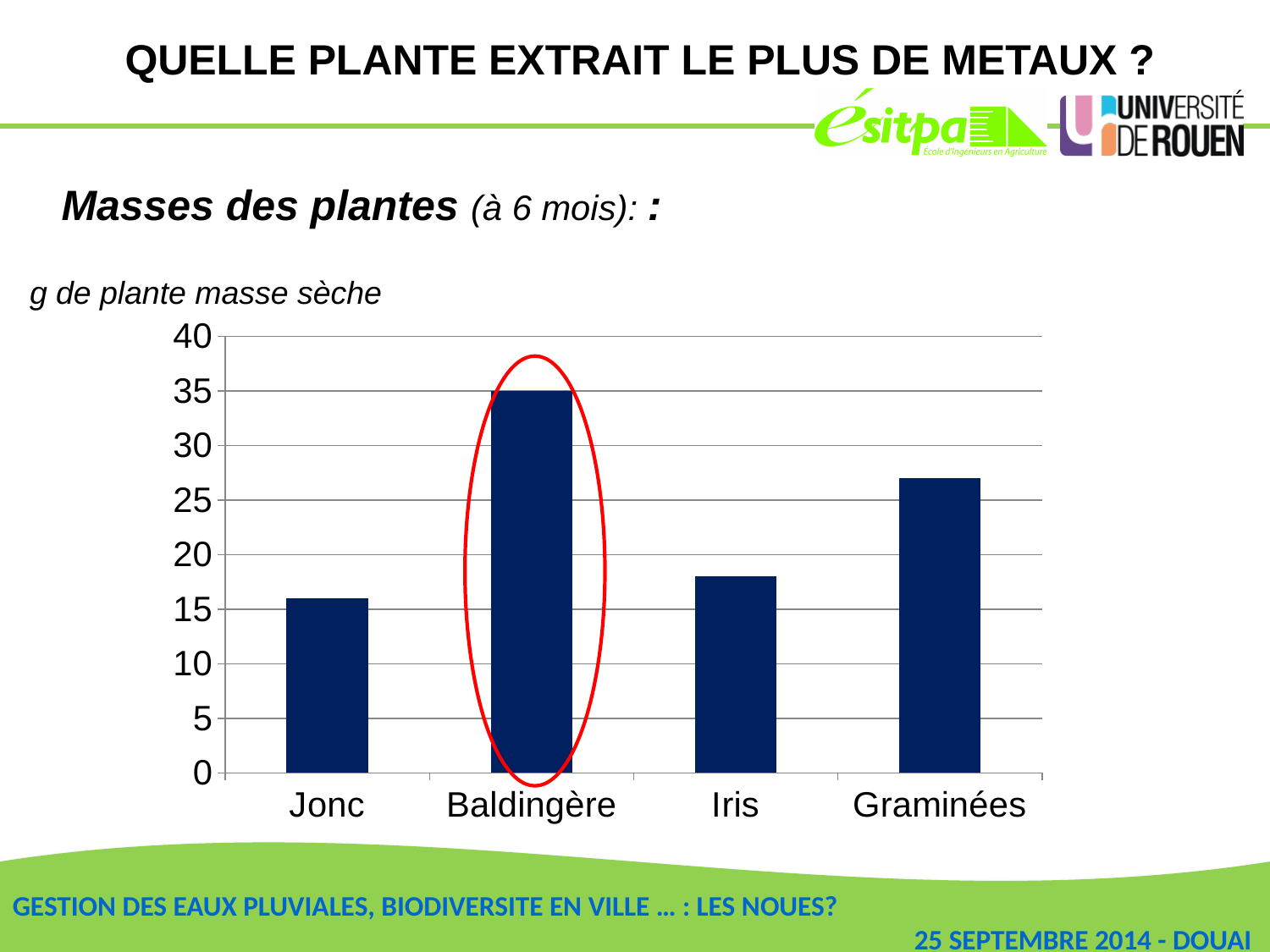
What type of chart is shown on the slide? bar chart What is the value for Baldingère on the chart? 35 Is the value for Iris greater or less than 20? less Which bar on the chart is circled in red? Baldingère Is the value for Graminées greater or less than 30? less Which plant has the lowest dry mass on the chart? Jonc Which plant has the highest dry mass on the chart? Baldingère Is the value for Graminées greater or less than 25? greater How many plant categories are plotted on the chart? 4 What unit label is written above the chart's vertical axis? g de plante masse sèche Which has a larger value, Graminées or Iris? Graminées